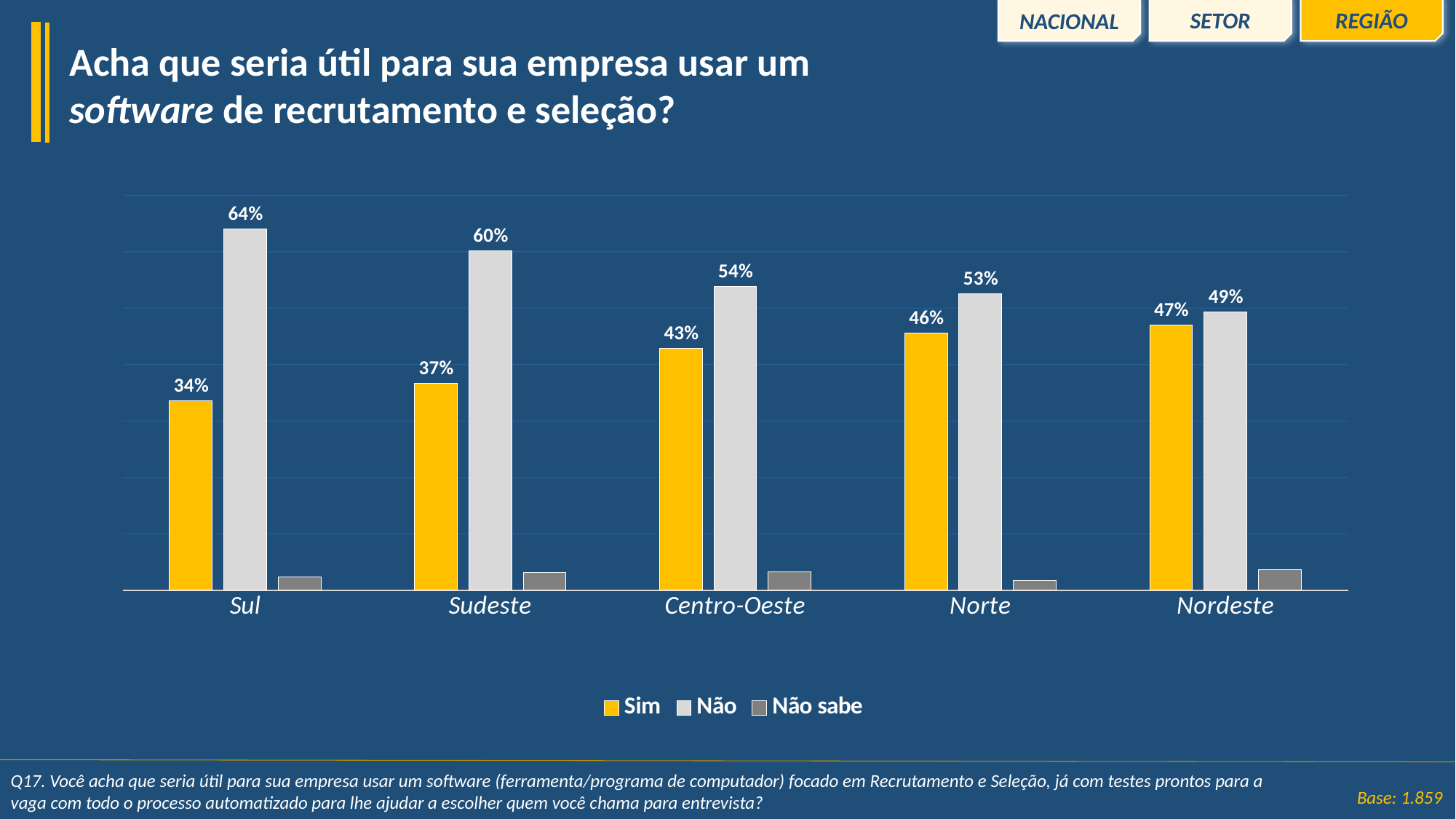
How many series does the legend list? 3 What is the value for "Não" in the Norte region? 53% Which region has the lowest value for "Sim"? Sul What kind of chart is shown on the slide? Bar chart Which is larger in the Nordeste region: the "Sim" value or the "Não" value? Não What is the value for "Sim" in the Nordeste region? 47% What is the value for "Não" in the Sudeste region? 60% How many regions are shown on the x axis? 5 Which colour represents the "Sim" series in the legend? Yellow Which region has the highest value for "Não"? Sul What is the difference between the "Não" and "Sim" values in the Centro-Oeste region? 11% What is the value for "Sim" in the Sul region? 34%